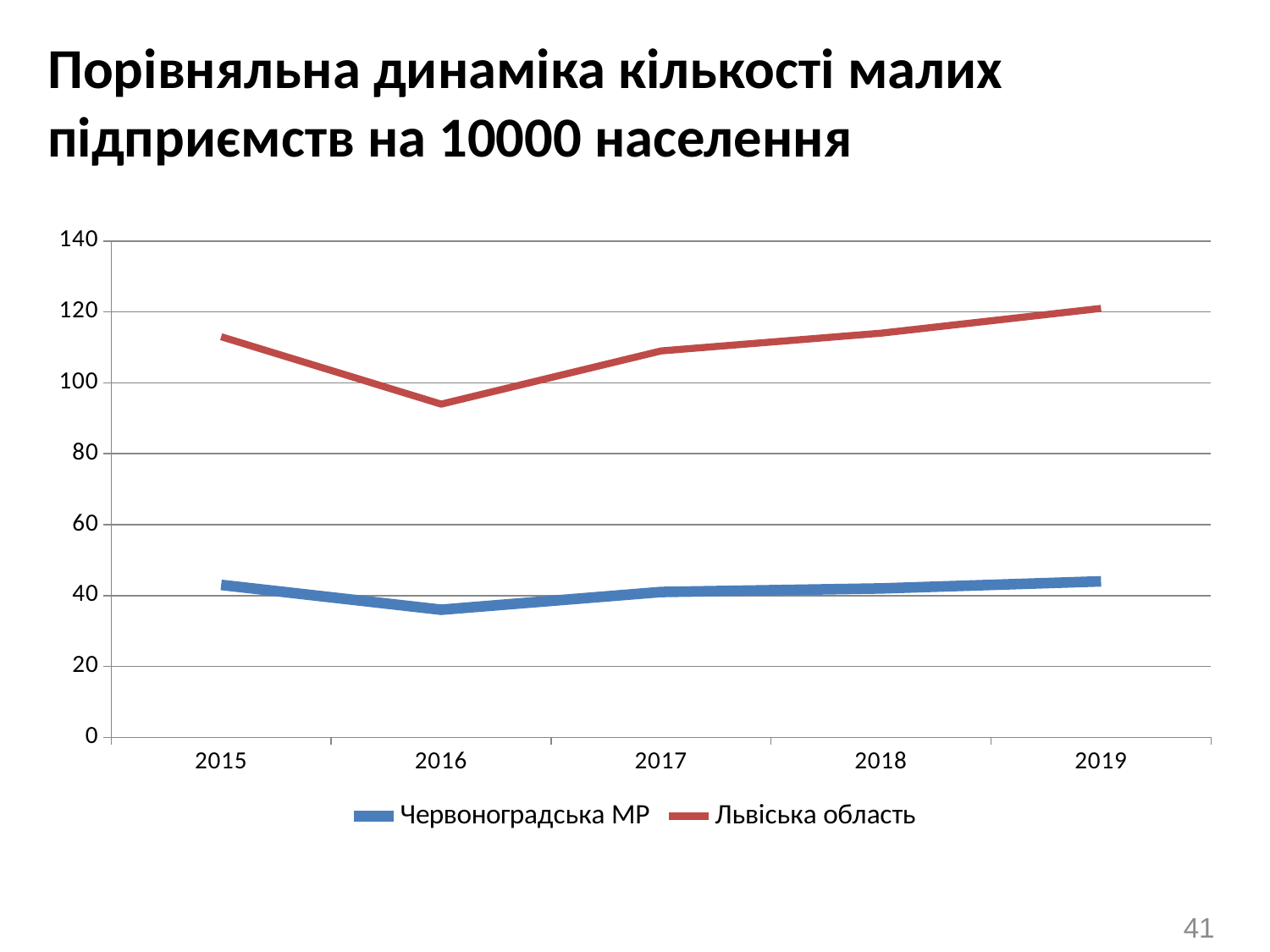
Is the value for Львіська область in 2015 greater or less than 100? greater What kind of chart is shown on the slide? line chart What colour is the line for Червоноградська МР? blue Does the value for Львіська область rise or fall from 2016 to 2019? rise In which year is the value for Львіська область highest? 2019 Is the value for Львіська область in 2016 greater or less than 100? less How many series does the legend list? 2 Is the value for Червоноградська МР in 2016 greater or less than 40? less Which series has the higher value in 2017, Червоноградська МР or Львіська область? Львіська область In which year is the value for Червоноградська МР lowest? 2016 In which year is the value for Львіська область lowest? 2016 How many years are shown on the x axis? 5